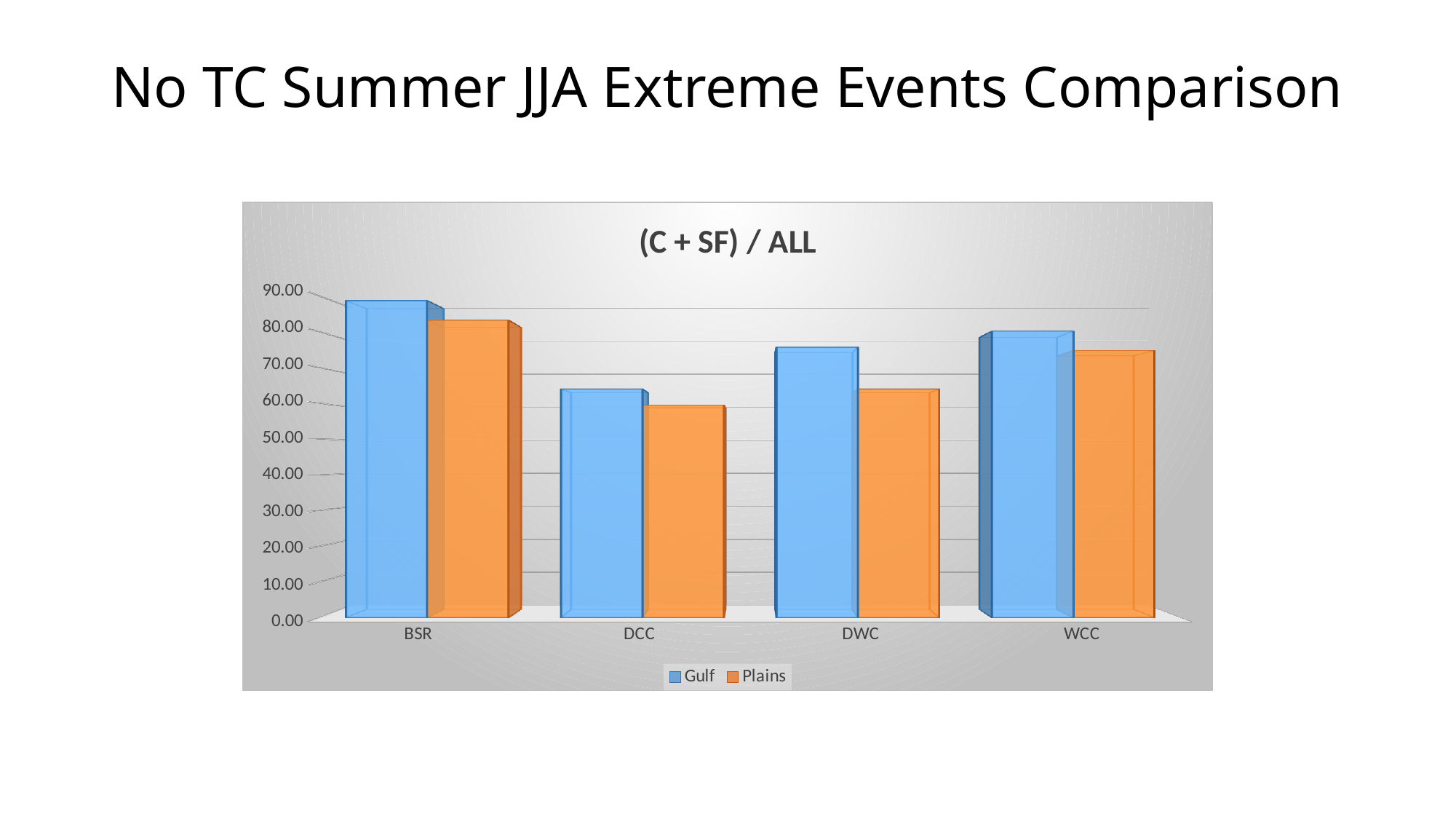
Which category has the lowest Plains value? DCC Which category has the highest Gulf value? BSR What kind of chart is shown on the slide? bar chart Which category has the lowest Gulf value? DCC Which colour represents the Plains series in the chart? orange How many categories are shown on the x axis of the chart? 4 Is the Gulf value for BSR greater or less than 80.00? greater For DWC, which series has the larger value, Gulf or Plains? Gulf Is the Plains value for WCC greater or less than 70.00? greater How many series does the chart's legend list? 2 What is the title of the chart? (C + SF) / ALL